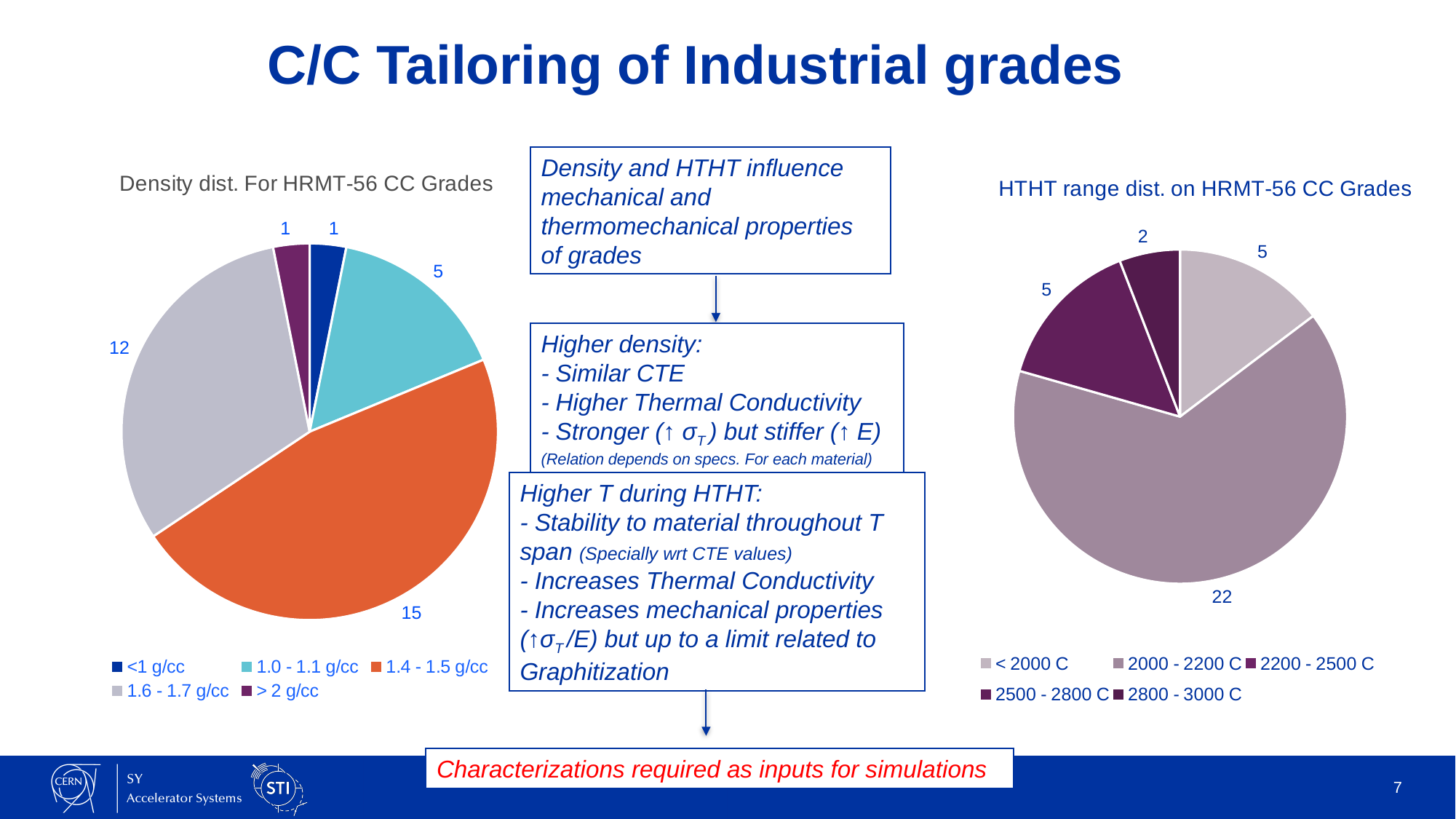
In the "Density dist. For HRMT-56 CC Grades" chart, what is the difference between the values for 1.4 - 1.5 g/cc and 1.6 - 1.7 g/cc? 3 In the "HTHT range dist. on HRMT-56 CC Grades" chart, what is the value for < 2000 C? 5 In the "Density dist. For HRMT-56 CC Grades" chart, what is the value for 1.4 - 1.5 g/cc? 15 In the "Density dist. For HRMT-56 CC Grades" chart, what is the value for 1.6 - 1.7 g/cc? 12 In the "Density dist. For HRMT-56 CC Grades" chart, which is larger: the value for 1.0 - 1.1 g/cc or the value for 1.6 - 1.7 g/cc? 1.6 - 1.7 g/cc In the "HTHT range dist. on HRMT-56 CC Grades" chart, what is the value for 2000 - 2200 C? 22 In the "Density dist. For HRMT-56 CC Grades" chart, which density category has the largest slice? 1.4 - 1.5 g/cc In the "Density dist. For HRMT-56 CC Grades" chart, what is the value for 1.0 - 1.1 g/cc? 5 What kind of chart is the "Density dist. For HRMT-56 CC Grades" chart on the left? pie chart How many categories does the legend of the "Density dist. For HRMT-56 CC Grades" chart list? 5 In the "HTHT range dist. on HRMT-56 CC Grades" chart, what is the difference between the values for 2000 - 2200 C and < 2000 C? 17 In the "HTHT range dist. on HRMT-56 CC Grades" chart, which HTHT range has the largest slice? 2000 - 2200 C